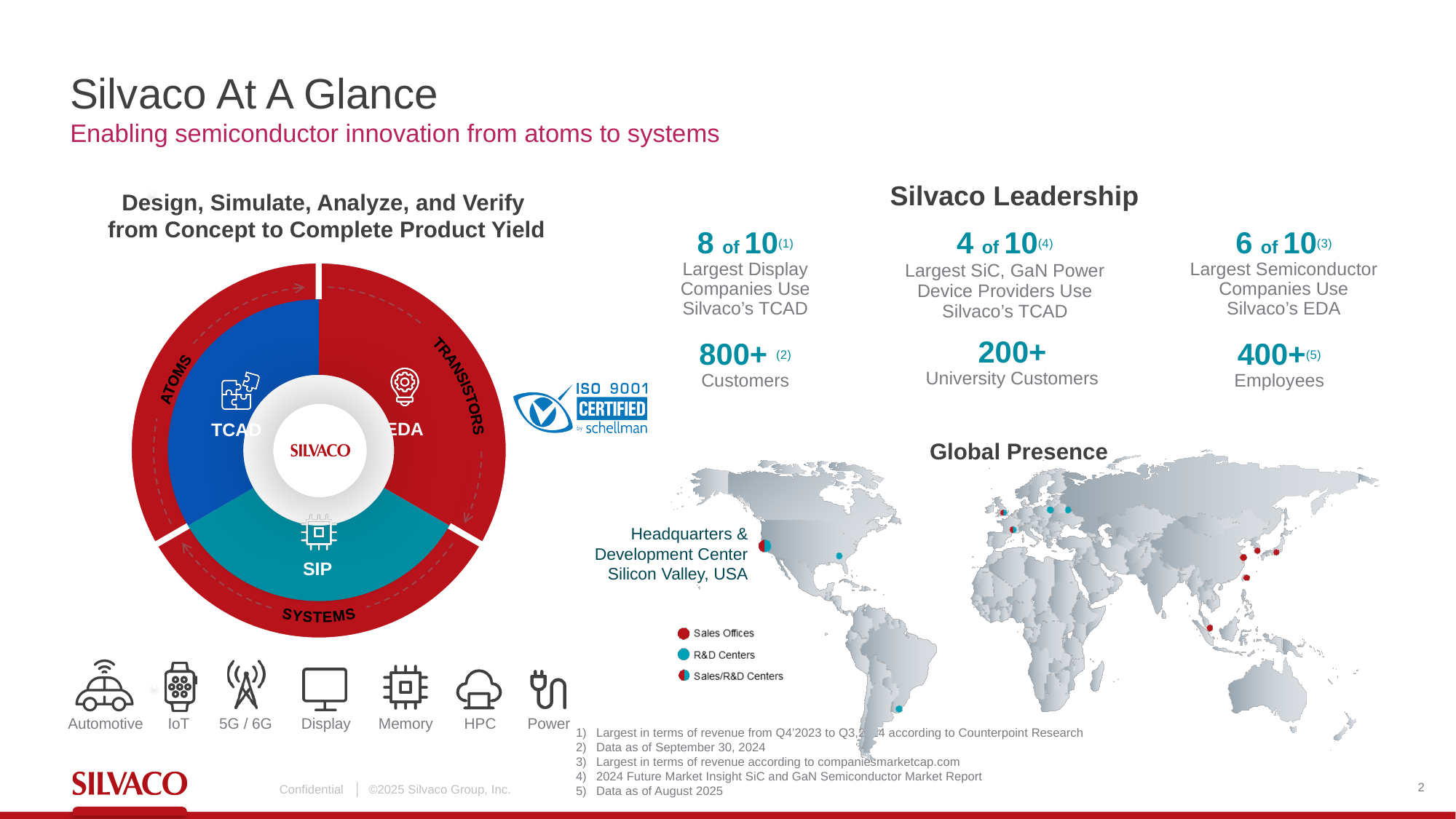
In the circular diagram on the left, how many inner segments are labeled? 3 On the Global Presence map, how many categories does the legend list? 3 On the Global Presence map, which legend entry is shown with a red marker? Sales Offices In the circular diagram on the left, what are the labels of the three inner segments? TCAD, EDA, SIP On the Global Presence map, what are the three legend entries? Sales Offices, R&D Centers, Sales/R&D Centers